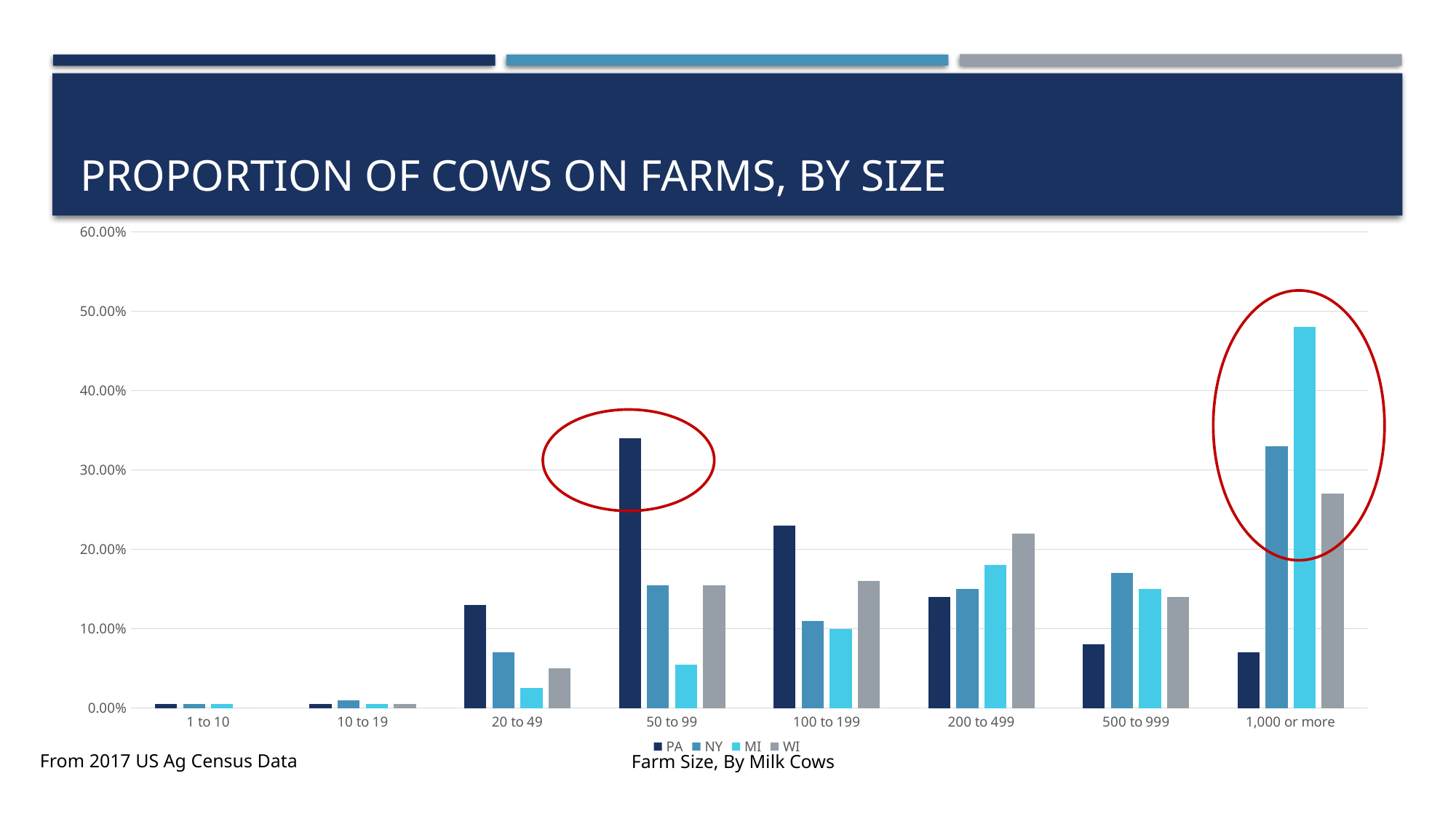
Which state has the lowest bar in the '20 to 49' category? MI What is the x-axis title of the chart? Farm Size, By Milk Cows In the '200 to 499' category, which is larger, the WI value or the PA value? WI Is the value for WI in the '1,000 or more' category greater or less than 20.00%? greater Is the value for PA in the '50 to 99' category greater or less than 30.00%? greater What kind of chart is shown on the slide? Bar chart In which farm size category is the PA bar the highest? 50 to 99 In the '500 to 999' category, which is larger, the NY value or the PA value? NY How many farm size categories are shown on the x axis? 8 How many series does the legend list? 4 Is the value for MI in the '1,000 or more' category greater or less than 40.00%? greater Which state has the highest bar in the '1,000 or more' category? MI